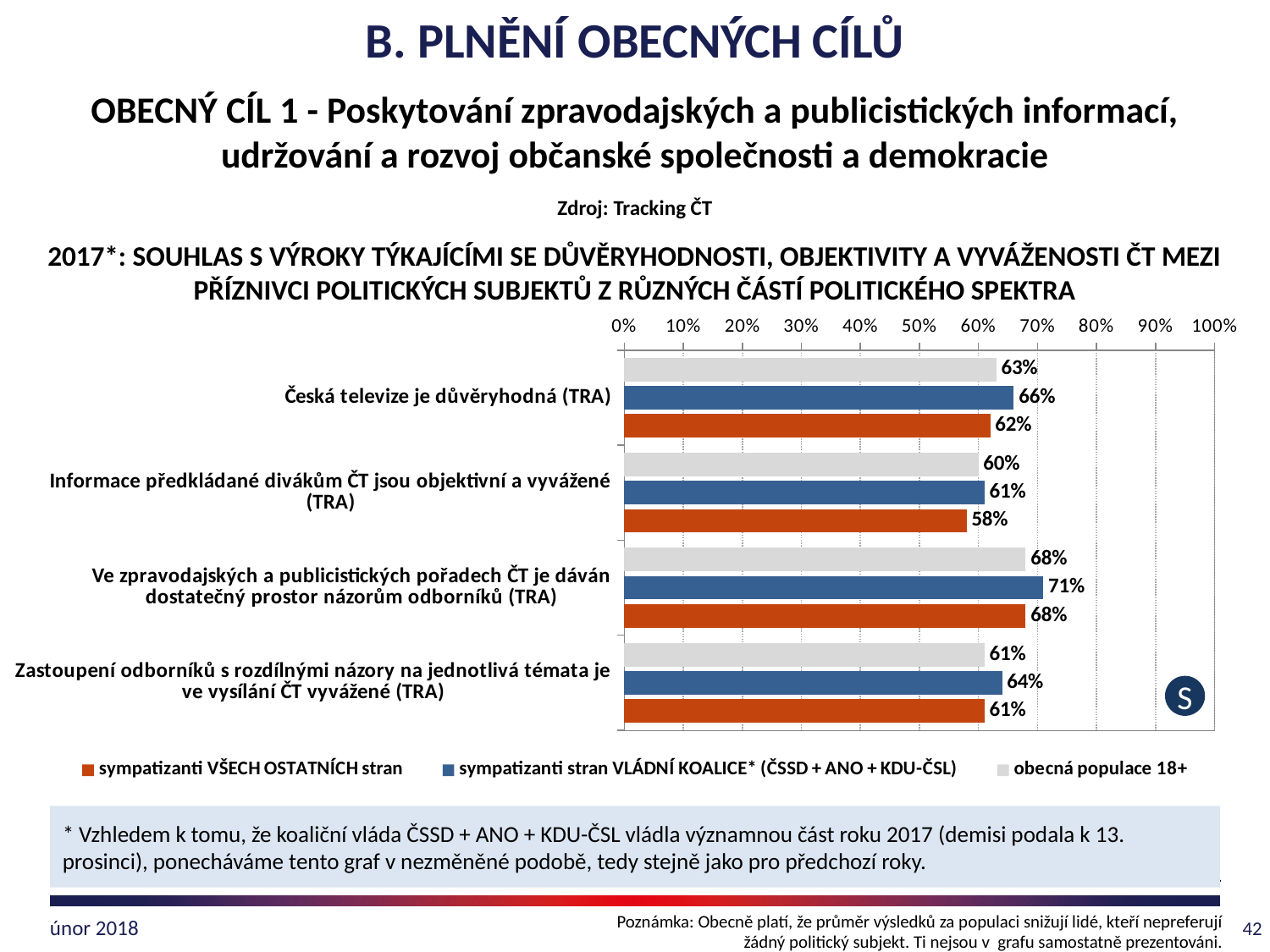
What is the difference between the 'sympatizanti stran VLÁDNÍ KOALICE' value and the 'sympatizanti VŠECH OSTATNÍCH stran' value for 'Česká televize je důvěryhodná (TRA)'? 4% Which statement has the lowest value for 'sympatizanti VŠECH OSTATNÍCH stran'? Informace předkládané divákům ČT jsou objektivní a vyvážené (TRA) What is the value for 'sympatizanti stran VLÁDNÍ KOALICE' for the statement 'Zastoupení odborníků s rozdílnými názory na jednotlivá témata je ve vysílání ČT vyvážené (TRA)'? 64% What is the value for 'sympatizanti stran VLÁDNÍ KOALICE' for the statement 'Česká televize je důvěryhodná (TRA)'? 66% Which statement has the highest value for 'sympatizanti stran VLÁDNÍ KOALICE'? Ve zpravodajských a publicistických pořadech ČT je dáván dostatečný prostor názorům odborníků (TRA) How many statements (categories) are plotted in the chart? 4 What is the value for 'sympatizanti VŠECH OSTATNÍCH stran' for the statement 'Ve zpravodajských a publicistických pořadech ČT je dáván dostatečný prostor názorům odborníků (TRA)'? 68% For 'Informace předkládané divákům ČT jsou objektivní a vyvážené (TRA)', which is larger: the value for 'obecná populace 18+' or for 'sympatizanti VŠECH OSTATNÍCH stran'? obecná populace 18+ What is the value for 'obecná populace 18+' for the statement 'Informace předkládané divákům ČT jsou objektivní a vyvážené (TRA)'? 60% How many series does the legend list? 3 What type of chart is shown on the slide? bar chart Which series is shown in orange in the chart? sympatizanti VŠECH OSTATNÍCH stran